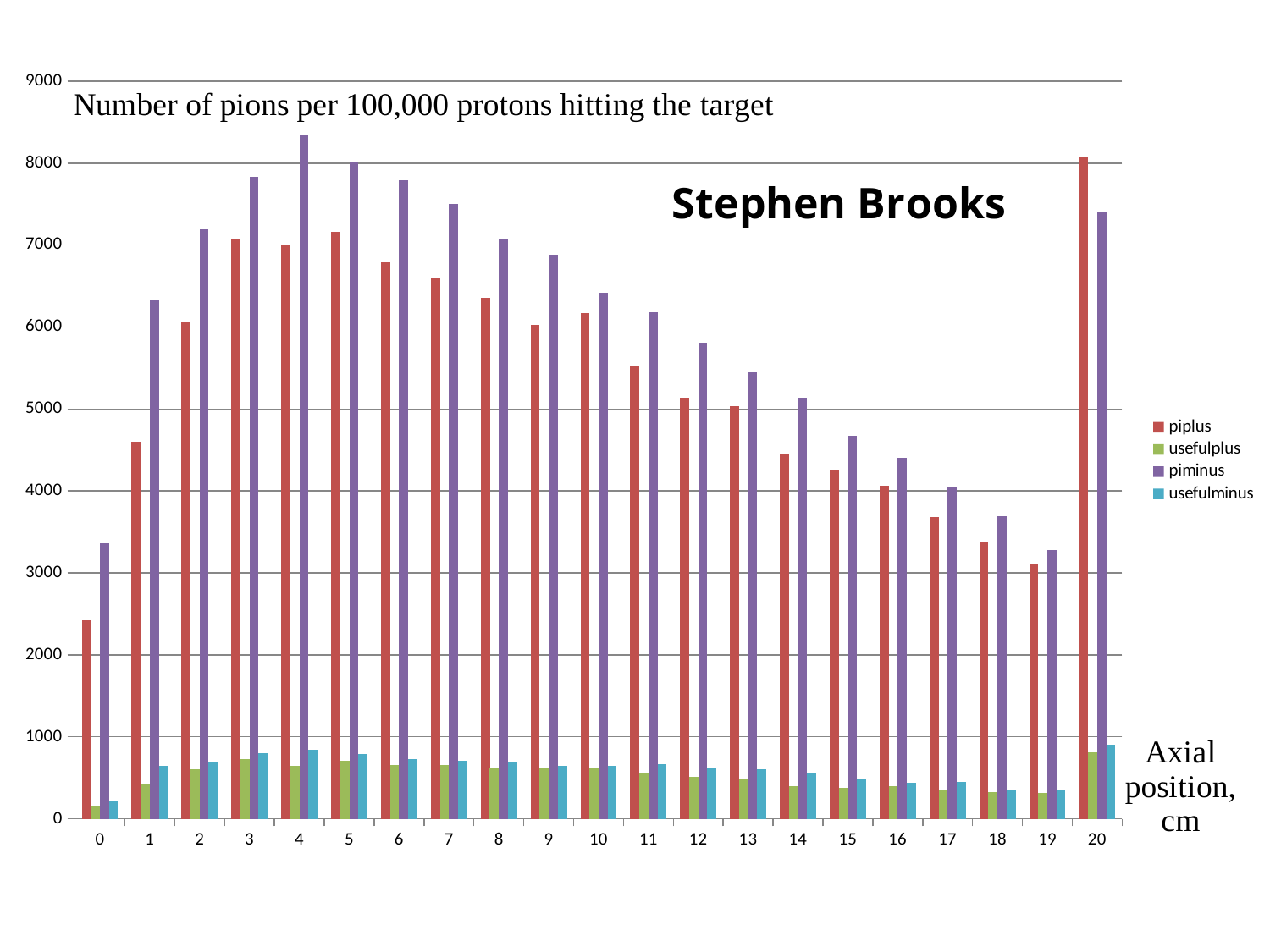
At axial position 20, which is larger, piplus or piminus? piplus At which axial position is the piplus value highest? 20 Is the piplus value at axial position 0 greater or less than 3000? less At which axial position is the piplus value lowest? 0 Is the piminus value at axial position 4 greater or less than 8000? greater At which axial position is the piminus value highest? 4 How many axial positions are plotted along the x axis? 21 At axial position 3, which is larger, piplus or piminus? piminus At which axial position is the usefulplus value lowest? 0 What kind of chart is shown on the slide? bar chart Do the piplus values rise or fall from axial position 5 to axial position 19? fall How many series does the legend list? 4